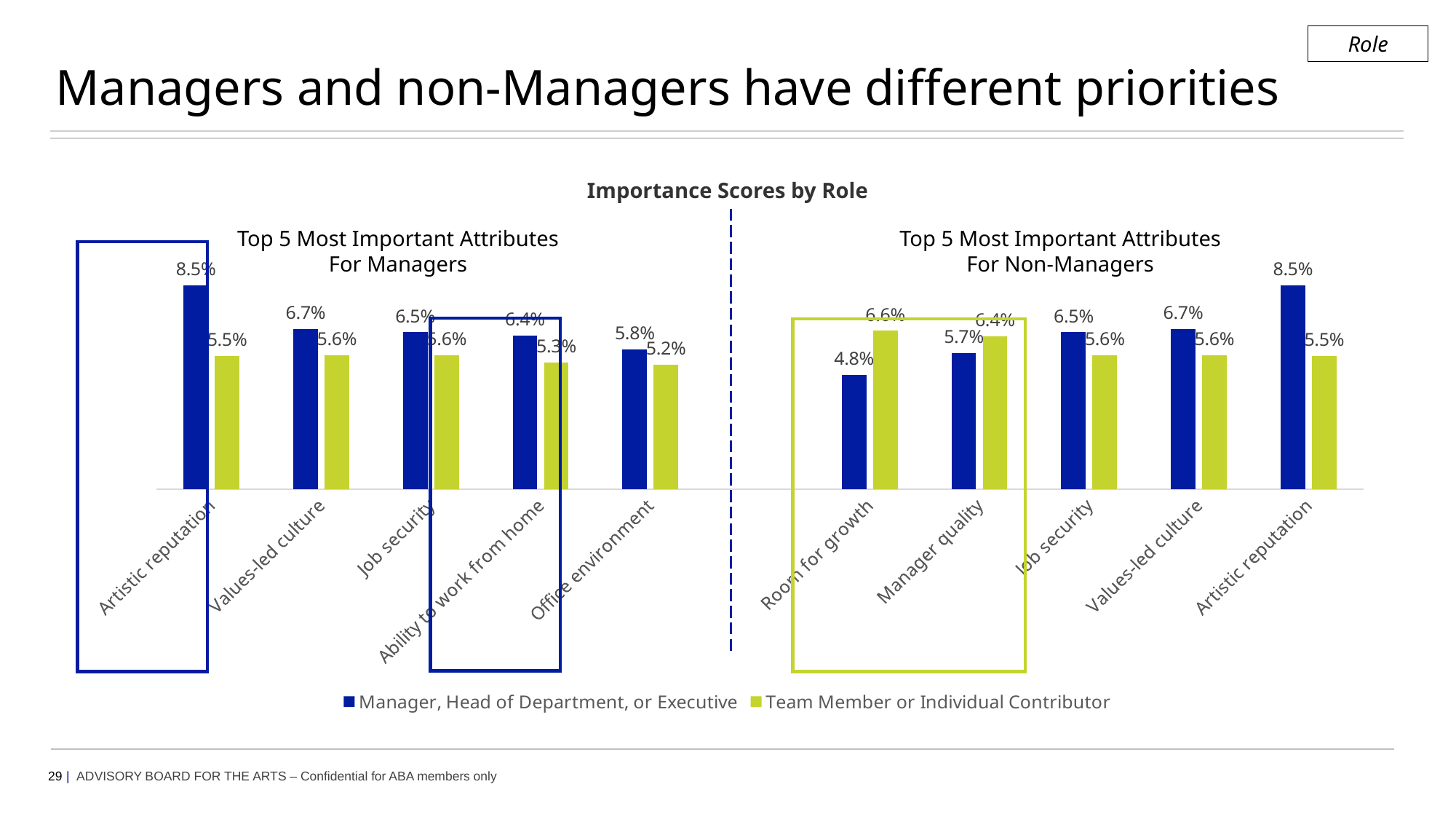
In the 'Top 5 Most Important Attributes For Non-Managers' panel, what is the value for Room for growth for the Team Member or Individual Contributor series? 6.6% In the 'Top 5 Most Important Attributes For Managers' panel, which attribute has the highest Manager, Head of Department, or Executive value? Artistic reputation In the 'Top 5 Most Important Attributes For Non-Managers' panel, which series has the larger value for Room for growth: Manager, Head of Department, or Executive, or Team Member or Individual Contributor? Team Member or Individual Contributor In the 'Top 5 Most Important Attributes For Non-Managers' panel, what is the Manager, Head of Department, or Executive value for Manager quality? 5.7% What kind of chart is the Importance Scores by Role chart? Bar chart In the 'Top 5 Most Important Attributes For Managers' panel, what is the Team Member or Individual Contributor value for Office environment? 5.2% How many attributes are shown in the 'Top 5 Most Important Attributes For Managers' panel? 5 In the 'Top 5 Most Important Attributes For Managers' panel, what is the value for Artistic reputation for the Manager, Head of Department, or Executive series? 8.5% In the 'Top 5 Most Important Attributes For Managers' panel, what is the difference between the Manager and Team Member values for Artistic reputation? 3.0% In the 'Top 5 Most Important Attributes For Non-Managers' panel, which attribute has the lowest Manager, Head of Department, or Executive value? Room for growth How many series does the legend of the Importance Scores by Role chart list? 2 In the Importance Scores by Role chart, which colour represents the Team Member or Individual Contributor series? Green